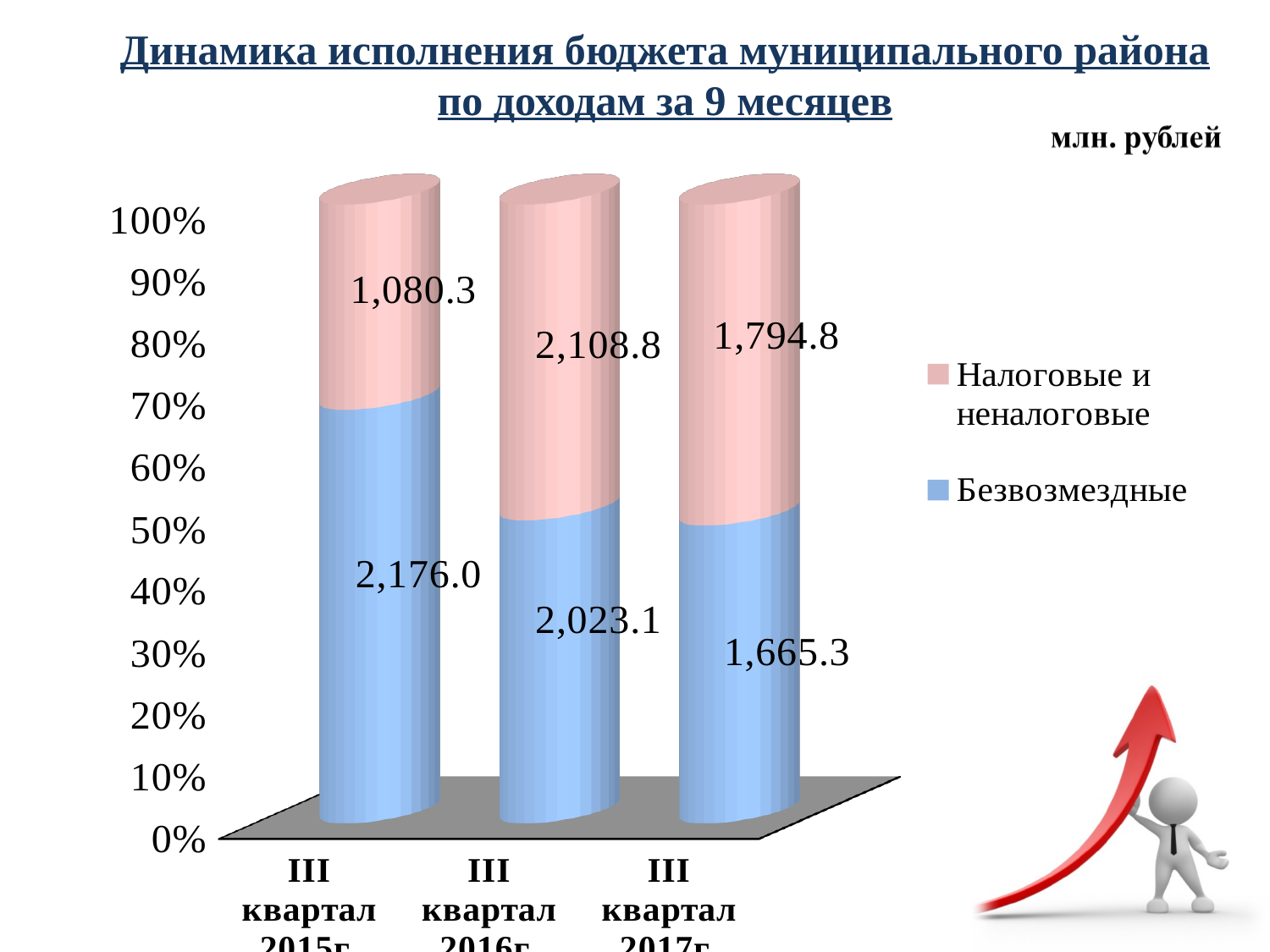
How many periods are shown on the x axis? 3 Which is larger in III квартал 2017г: Налоговые и неналоговые or Безвозмездные? Налоговые и неналоговые What is the difference between the Безвозмездные and Налоговые и неналоговые values in III квартал 2015г? 1,095.7 What value is shown for Безвозмездные in III квартал 2017г? 1,665.3 What value is shown for Безвозмездные in III квартал 2016г? 2,023.1 In which period is the Безвозмездные value the lowest? III квартал 2017г What kind of chart is shown on the slide? Stacked bar chart What unit is indicated for the values on the chart? млн. рублей What value is shown for Налоговые и неналоговые in III квартал 2015г? 1,080.3 In which period is the Налоговые и неналоговые value the highest? III квартал 2016г What is the total of the two series for III квартал 2016г? 4,131.9 How many series does the legend list? 2